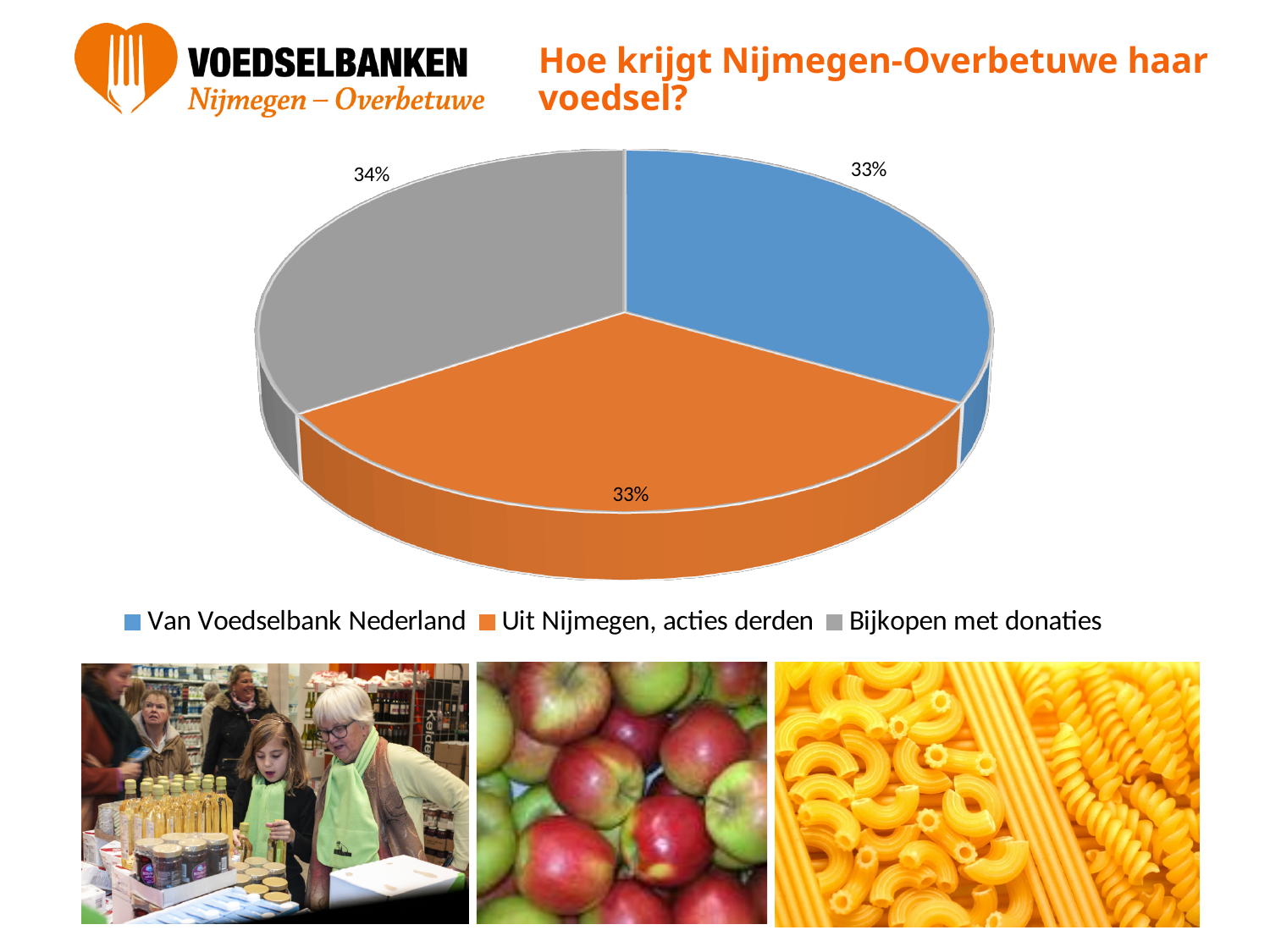
What is the difference in percentage points between 'Bijkopen met donaties' and 'Van Voedselbank Nederland'? 1% What percentage of the pie is labelled for 'Van Voedselbank Nederland'? 33% What type of chart is shown on the slide? pie chart How many slices does the pie chart have? 3 What is the title of the chart on the slide? Hoe krijgt Nijmegen-Overbetuwe haar voedsel? How many entries does the legend list? 3 Which colour represents 'Uit Nijmegen, acties derden' in the pie chart? orange What percentage of the pie is labelled for 'Bijkopen met donaties'? 34% What percentage of the pie is labelled for 'Uit Nijmegen, acties derden'? 33% Which is larger: the share for 'Bijkopen met donaties' or the share for 'Uit Nijmegen, acties derden'? Bijkopen met donaties Which category has the largest share of the pie? Bijkopen met donaties